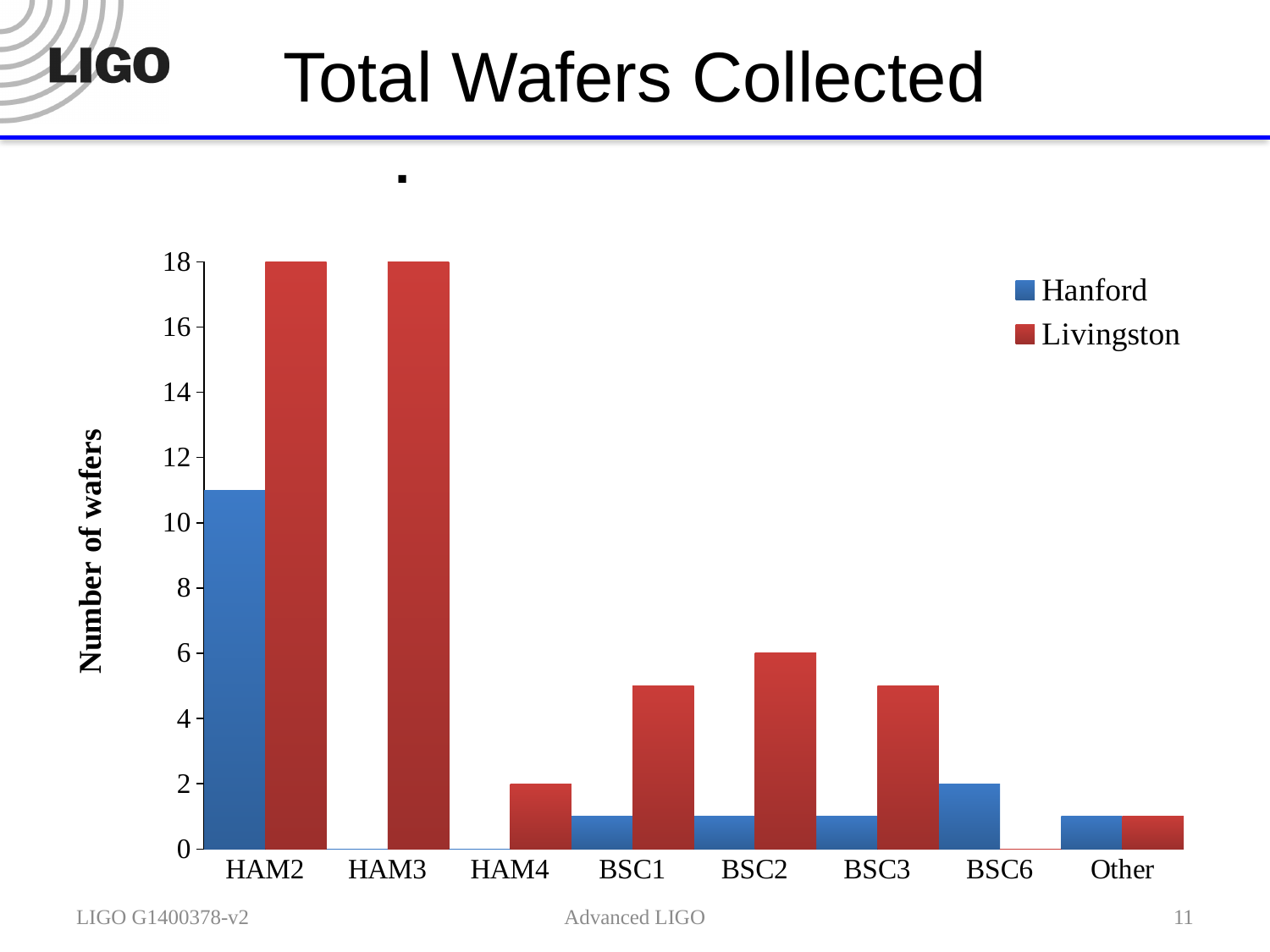
How many series does the legend list? 2 What is the difference between the Livingston values for HAM2 and HAM4? 16 Is the Hanford value for HAM2 greater or less than 10? greater What is the Livingston value for BSC2? 6 Which category has the highest Hanford value? HAM2 Is the Livingston value for BSC1 greater or less than 6? less How many categories are shown on the x axis? 8 What is the Livingston value for HAM3? 18 What is the label on the y axis? Number of wafers What kind of chart is shown on the slide? bar chart What is the Hanford value for BSC6? 2 What is the Livingston value for HAM2? 18